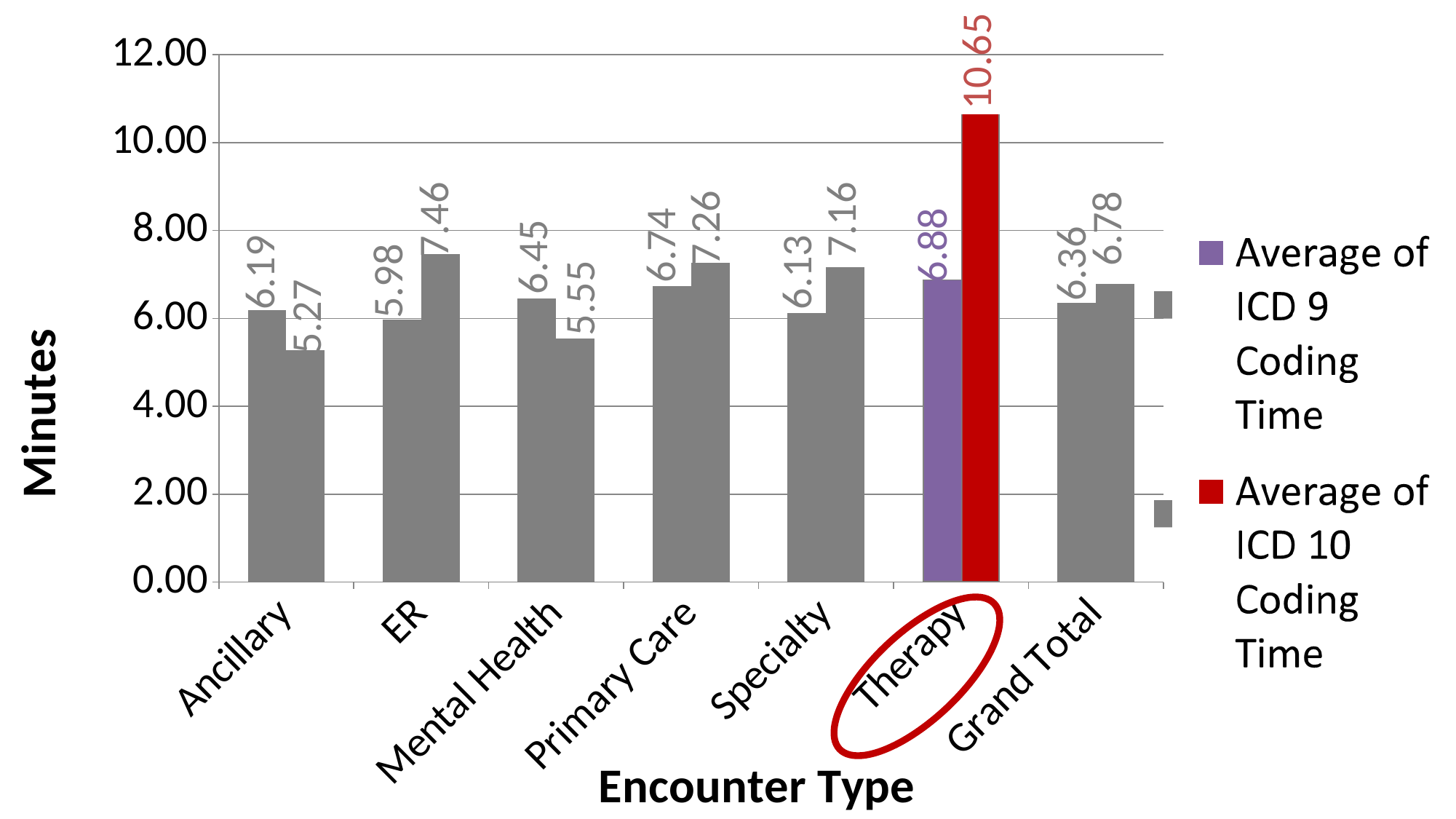
What is the Average of ICD 10 Coding Time for ER? 7.46 What kind of chart is shown on the slide? Bar chart What is the label of the y axis? Minutes What is the Average of ICD 10 Coding Time for Therapy? 10.65 How many encounter types are shown on the x axis? 7 What is the Average of ICD 9 Coding Time for Mental Health? 6.45 Is the Average of ICD 10 Coding Time for Therapy greater or less than 10.00? greater Which encounter type has the lowest Average of ICD 10 Coding Time? Ancillary Which encounter type has the highest Average of ICD 10 Coding Time? Therapy What is the difference between the ICD 10 and ICD 9 average coding times for Therapy? 3.77 How many series does the legend list? 2 For Mental Health, which is larger: the Average of ICD 9 Coding Time or the Average of ICD 10 Coding Time? Average of ICD 9 Coding Time